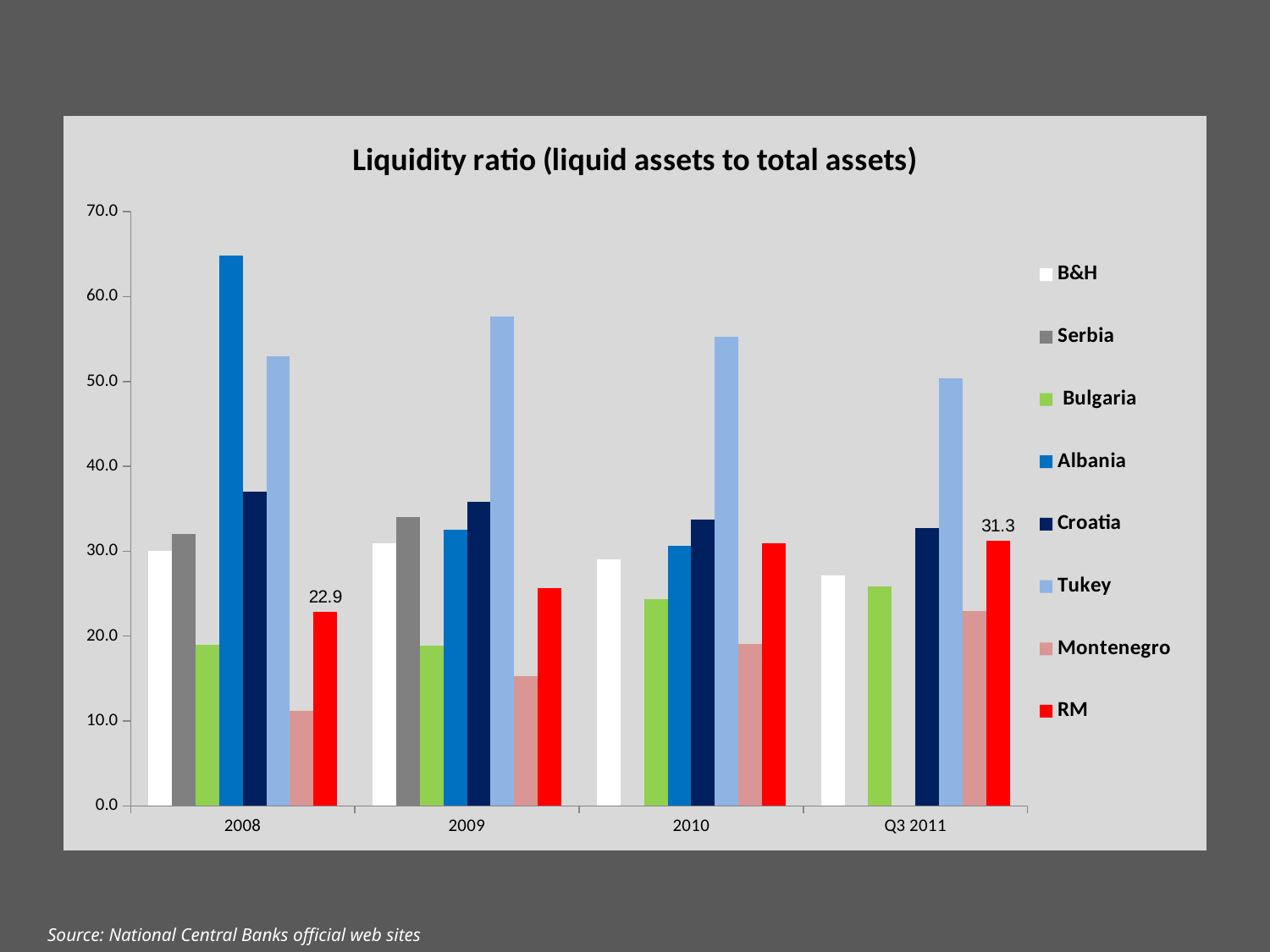
Which is larger for RM: the 2008 value or the Q3 2011 value? Q3 2011 What kind of chart is shown on the slide? bar chart What is the liquidity ratio for RM in 2008? 22.9 Do the RM values rise or fall from 2008 to Q3 2011? rise Which country has the highest liquidity ratio in 2009? Tukey Which country has the highest liquidity ratio in 2008? Albania By how much did the RM liquidity ratio change from 2008 to Q3 2011? 8.4 How many periods are shown on the x axis? 4 How many series does the legend list? 8 Is the value for Albania in 2008 greater or less than 60.0? greater Which country has the lowest liquidity ratio in 2008? Montenegro What is the liquidity ratio for RM in Q3 2011? 31.3